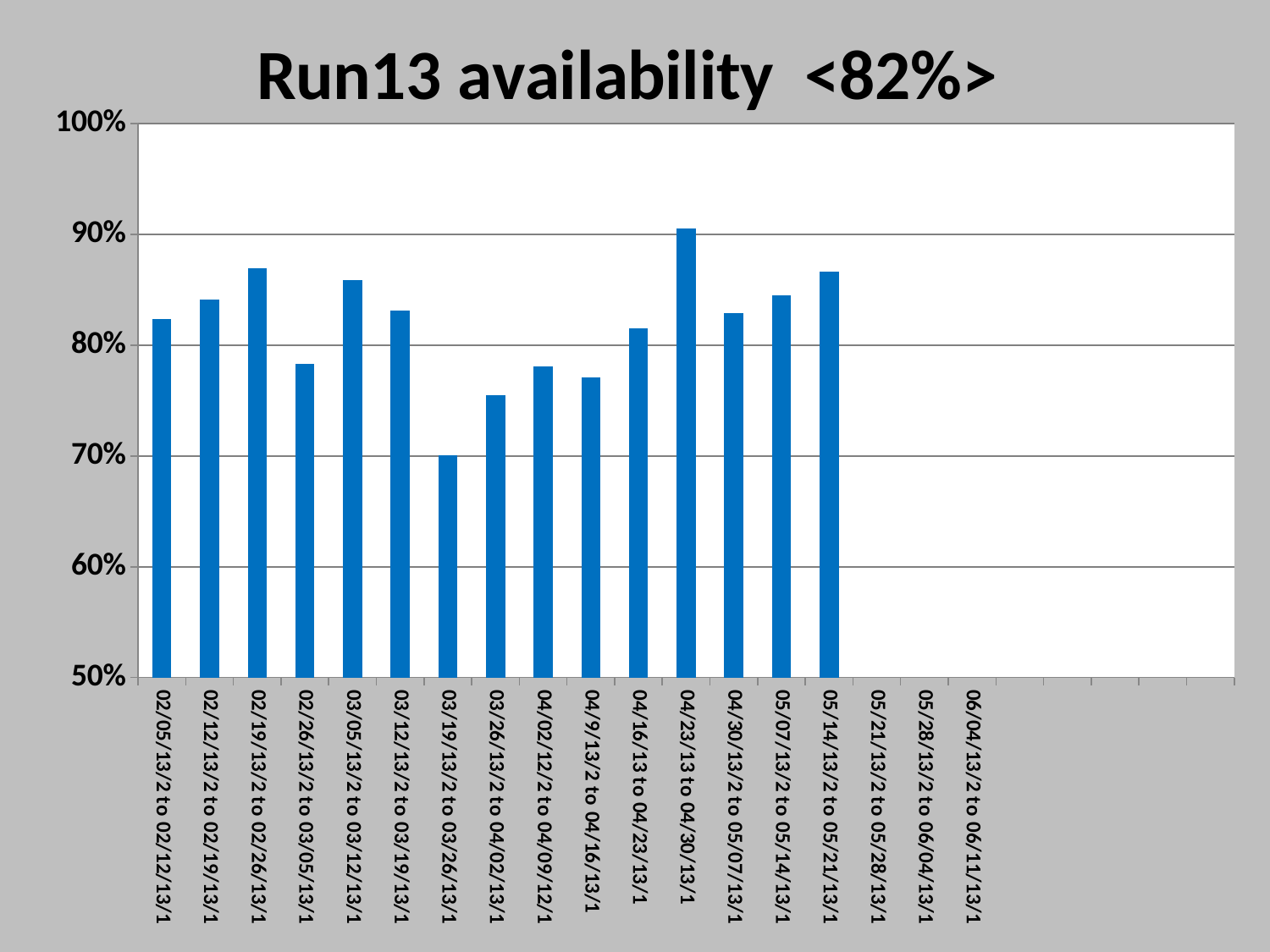
How many week labels are shown on the x axis? 18 Is the value for 03/26/13/2 to 04/02/13/1 greater or less than 80%? less What type of chart is shown on the slide? bar chart Is the value for 02/19/13/2 to 02/26/13/1 greater or less than 80%? greater Do the values rise or fall from 03/05/13/2 to 03/12/13/1 through 03/19/13/2 to 03/26/13/1? fall Which is larger, the value for 04/23/13 to 04/30/13/1 or for 04/30/13/2 to 05/07/13/1? 04/23/13 to 04/30/13/1 Which week has the lowest availability? 03/19/13/2 to 03/26/13/1 Which is larger, the value for 02/19/13/2 to 02/26/13/1 or for 02/26/13/2 to 03/05/13/1? 02/19/13/2 to 02/26/13/1 What is the title of the chart? Run13 availability <82%> How many bars are plotted on the chart? 15 Is the value for 02/26/13/2 to 03/05/13/1 greater or less than 80%? less Which week has the highest availability? 04/23/13 to 04/30/13/1